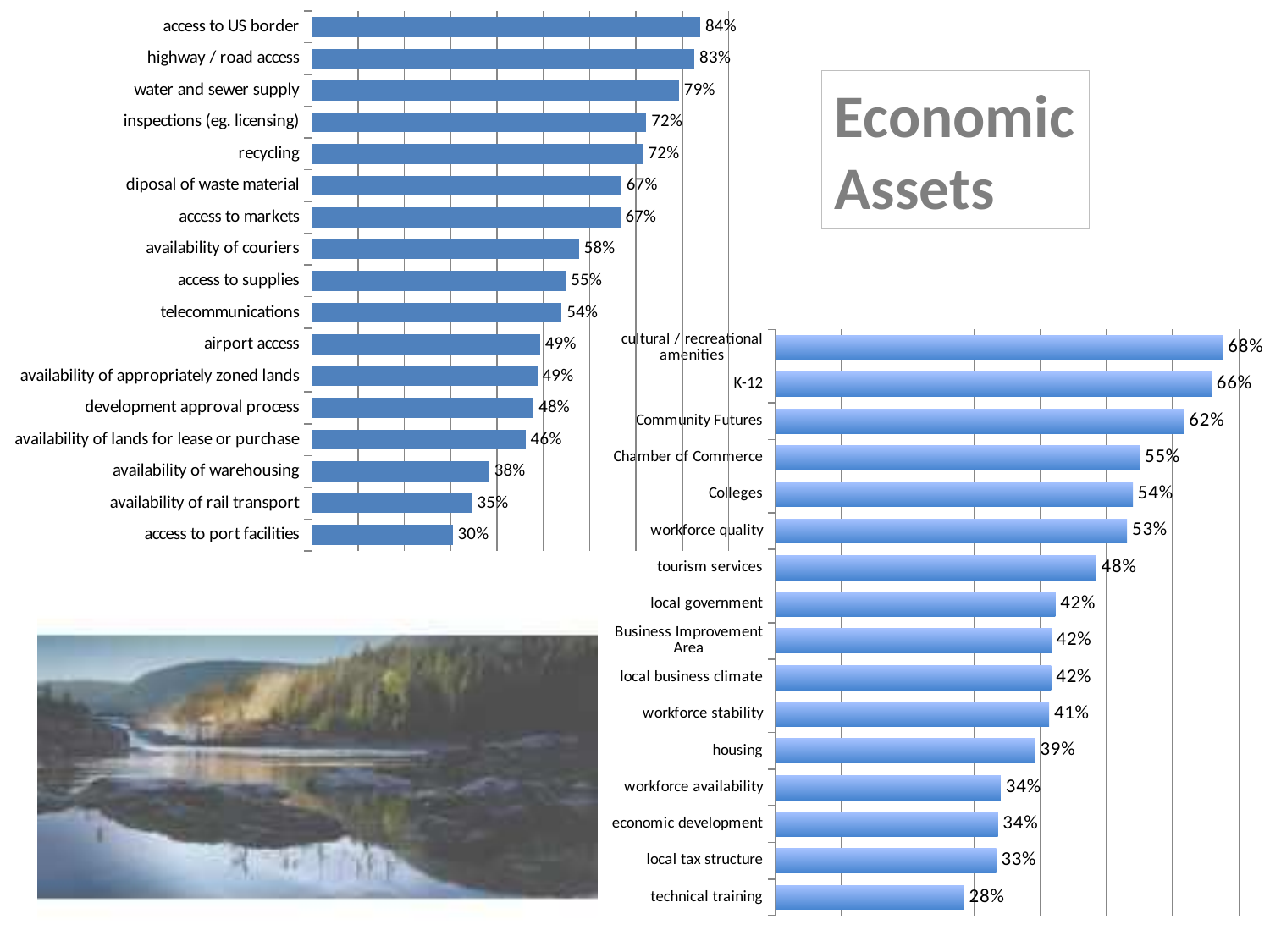
In the bottom-right chart, which category has the highest value? cultural / recreational amenities How many categories are shown in the bottom-right chart? 16 In the bottom-right chart, what is the difference between K-12 and housing? 27% In the top-left chart, which category has the lowest value? access to port facilities In the bottom-right chart, what is the value for technical training? 28% In the top-left chart, what is the value for availability of warehousing? 38% In the bottom-right chart, what is the value for Community Futures? 62% What type of chart is the bottom-right chart? bar chart In the top-left chart, which is larger: availability of couriers or access to supplies? availability of couriers In the top-left chart, what is the value for access to US border? 84% In the top-left chart, what is the difference between water and sewer supply and telecommunications? 25% How many categories are shown in the top-left chart? 17